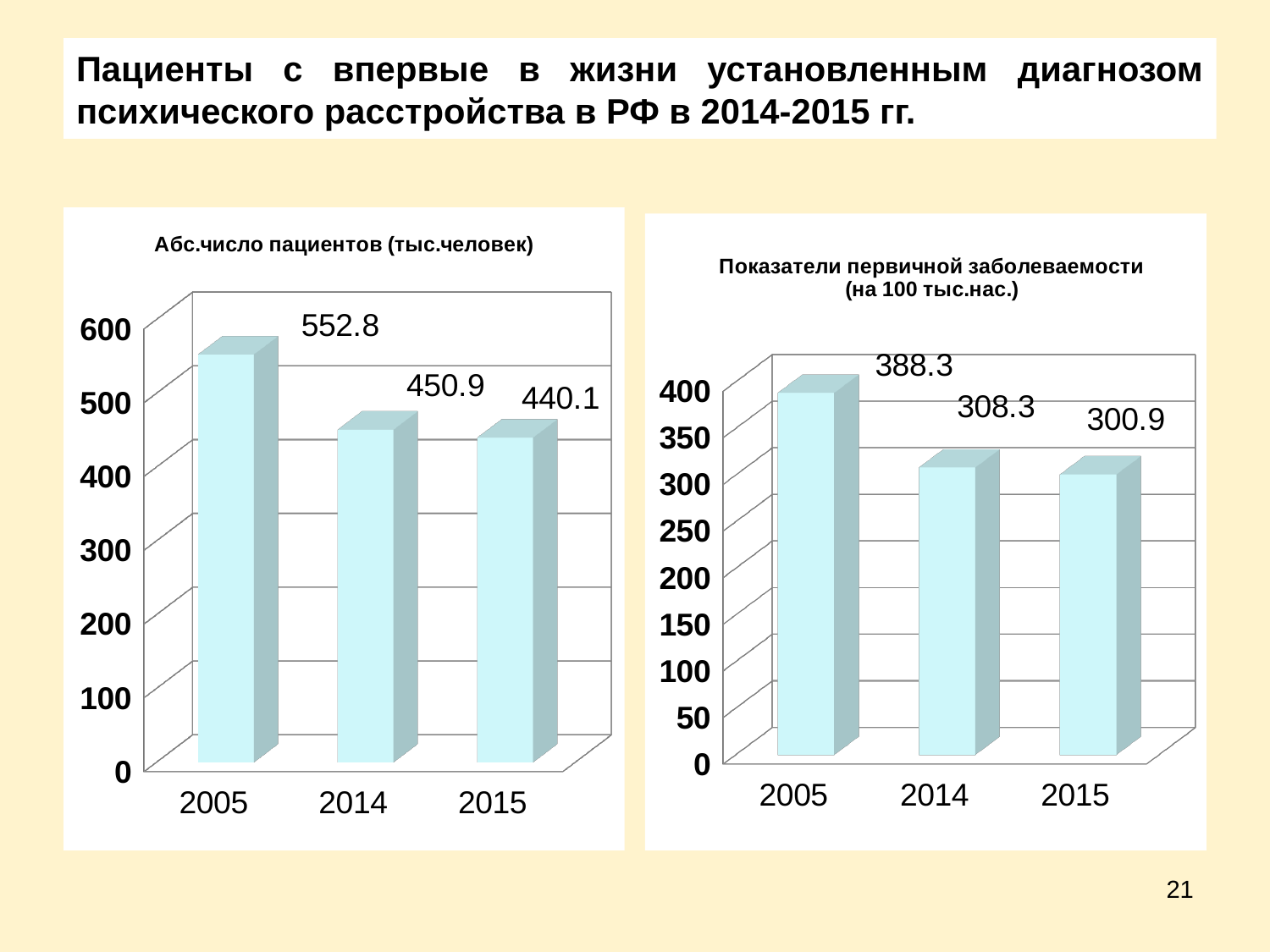
What kind of chart is the right chart (Показатели первичной заболеваемости)? bar chart In the right chart (Показатели первичной заболеваемости), which is larger, the value for 2005 or the value for 2015? 2005 In the left chart (Абс.число пациентов), do the values rise or fall from 2005 to 2015? fall How many years are shown on the x axis of the left chart (Абс.число пациентов)? 3 What is the title of the left chart? Абс.число пациентов (тыс.человек) In the left chart (Абс.число пациентов), what is the value for 2005? 552.8 In the left chart (Абс.число пациентов), what is the value for 2015? 440.1 In the right chart (Показатели первичной заболеваемости), what is the difference between the 2014 and 2015 values? 7.4 In the right chart (Показатели первичной заболеваемости), which year has the highest value? 2005 In the left chart (Абс.число пациентов), what is the difference between the 2005 and 2014 values? 101.9 In the right chart (Показатели первичной заболеваемости), what is the value for 2014? 308.3 In the left chart (Абс.число пациентов), which year has the lowest value? 2015